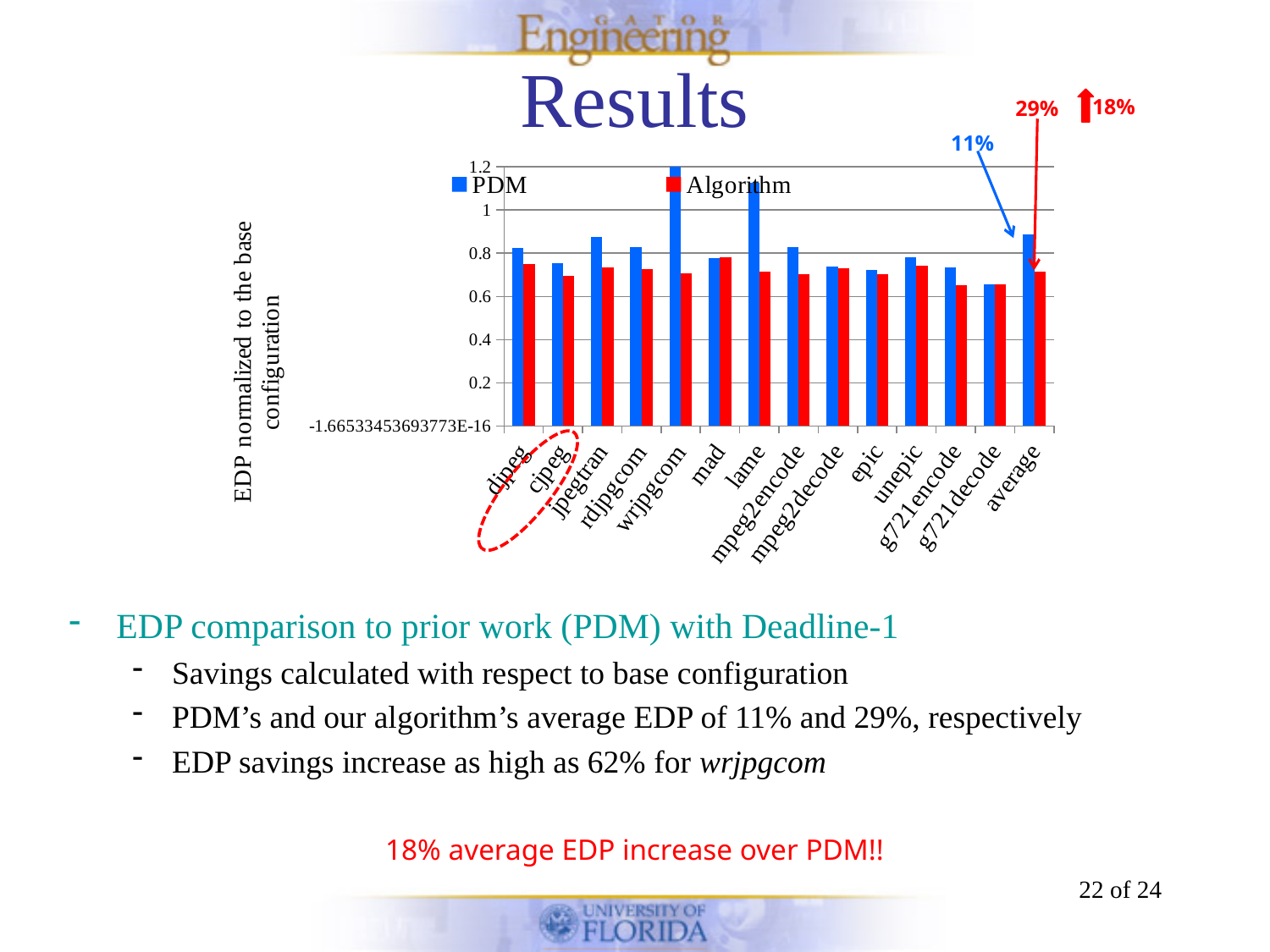
How many series does the chart's legend list? 2 Is the PDM value for wrjpgcom greater or less than 1? greater Is the PDM value for jpegtran greater or less than 0.8? greater For wrjpgcom, which series has the larger value, PDM or Algorithm? PDM What are the two series named in the chart's legend? PDM and Algorithm Is the PDM value for lame greater or less than 1? greater How many categories are shown along the x axis of the chart? 14 What kind of chart is shown on the slide? bar chart Which category has the lowest PDM value in the chart? g721decode Which category has the highest PDM value in the chart? wrjpgcom What is the label on the vertical axis of the chart? EDP normalized to the base configuration